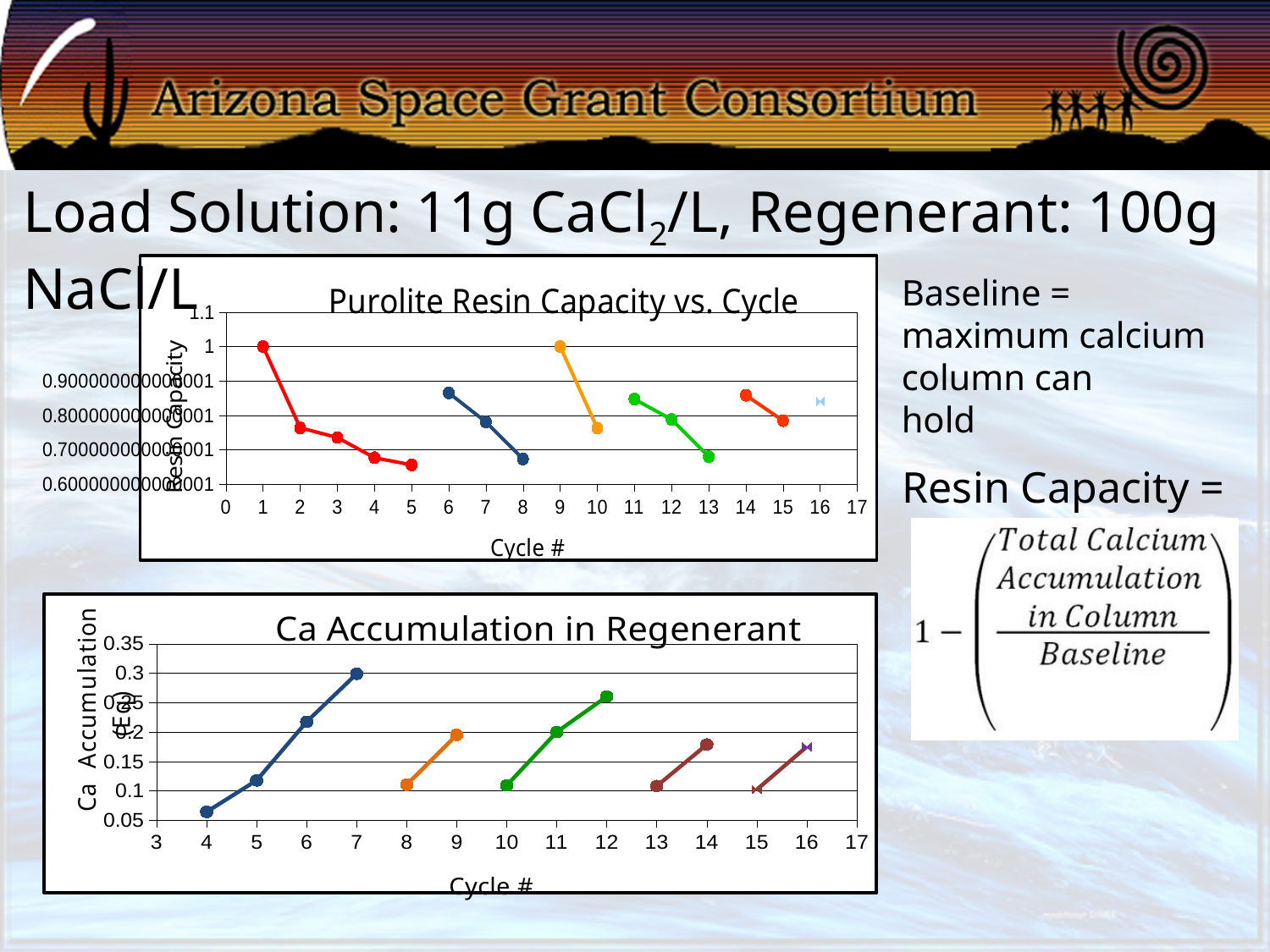
In the 'Purolite Resin Capacity vs. Cycle' chart, is the value at cycle 6 greater or less than 0.8? greater In the 'Purolite Resin Capacity vs. Cycle' chart, is the value at cycle 5 greater or less than 0.7? less In the 'Purolite Resin Capacity vs. Cycle' chart, which is larger, the value at cycle 1 or the value at cycle 5? cycle 1 In the 'Ca Accumulation in Regenerant' chart, which cycle has the highest Ca accumulation? cycle 7 What is the x-axis label of the 'Purolite Resin Capacity vs. Cycle' chart? Cycle # In the 'Purolite Resin Capacity vs. Cycle' chart, do the values within each line segment rise or fall as the cycle number increases? fall What is the title of the bottom chart on the slide? Ca Accumulation in Regenerant In the 'Ca Accumulation in Regenerant' chart, is the value at cycle 14 greater or less than 0.2? less In the 'Purolite Resin Capacity vs. Cycle' chart, how many data points does the red line segment (cycles 1 to 5) have? 5 In the 'Purolite Resin Capacity vs. Cycle' chart, what is the resin capacity at cycle 1? 1 What kind of chart is the 'Purolite Resin Capacity vs. Cycle' chart? line chart